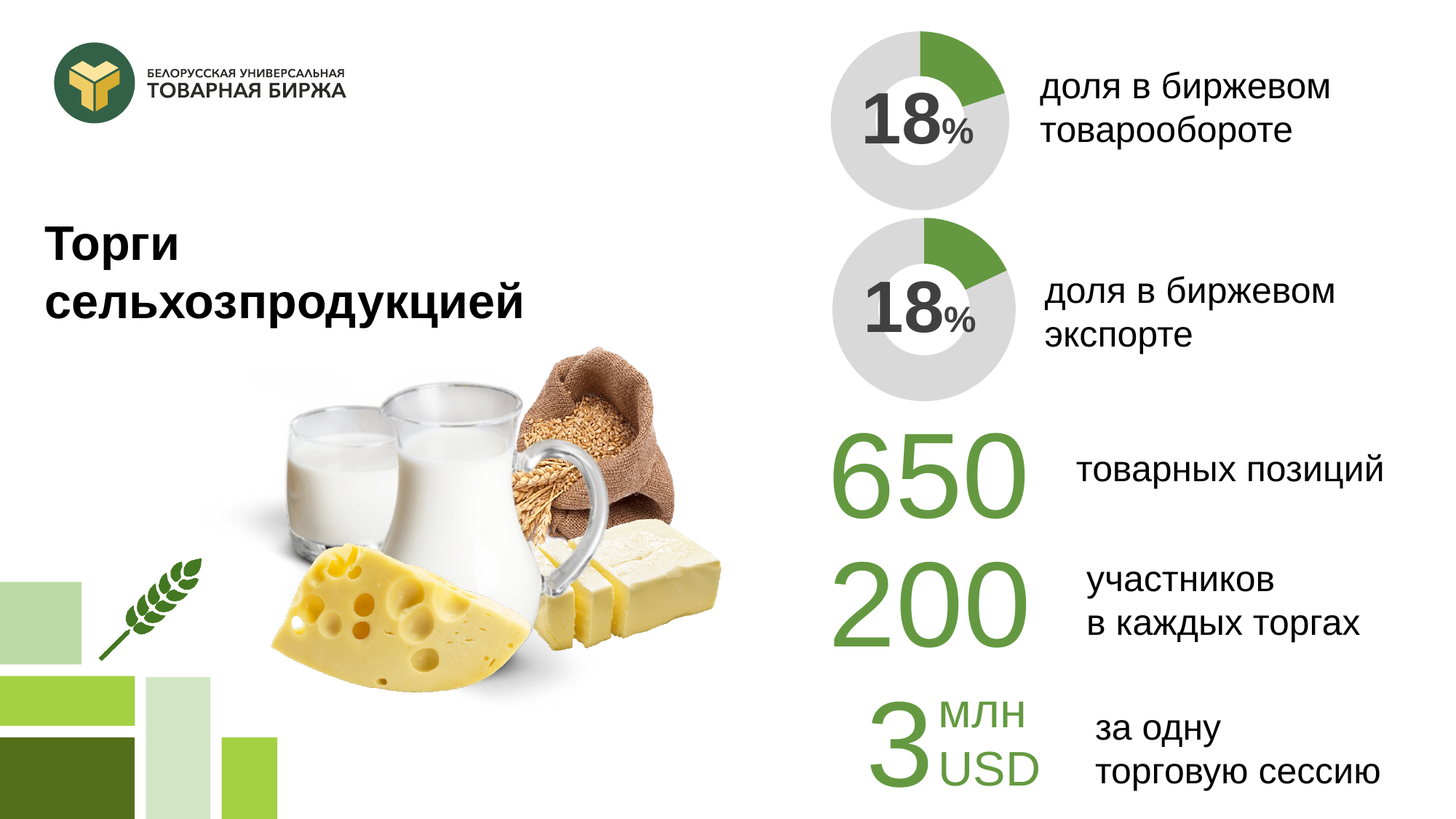
In the donut chart for "доля в биржевом экспорте", is the highlighted share greater or less than 25%? less What share is shown in the top donut chart labelled "доля в биржевом товарообороте"? 18% What colour is the remaining (non-highlighted) part of the donut charts? Grey What share is shown in the second donut chart labelled "доля в биржевом экспорте"? 18% What is the difference between the share shown in the top donut chart and the share shown in the second donut chart? 0% In the top donut chart, is the highlighted share greater or less than 50%? less What kind of chart is used to show the share in exchange turnover (доля в биржевом товарообороте)? Donut (pie) chart How many donut charts are shown on the slide? 2 What colour is the highlighted segment in the donut charts? Green What share of the top donut chart is not highlighted in green? 82% Is the share in the top donut chart (товарооборот) larger than, smaller than, or equal to the share in the second donut chart (экспорт)? equal